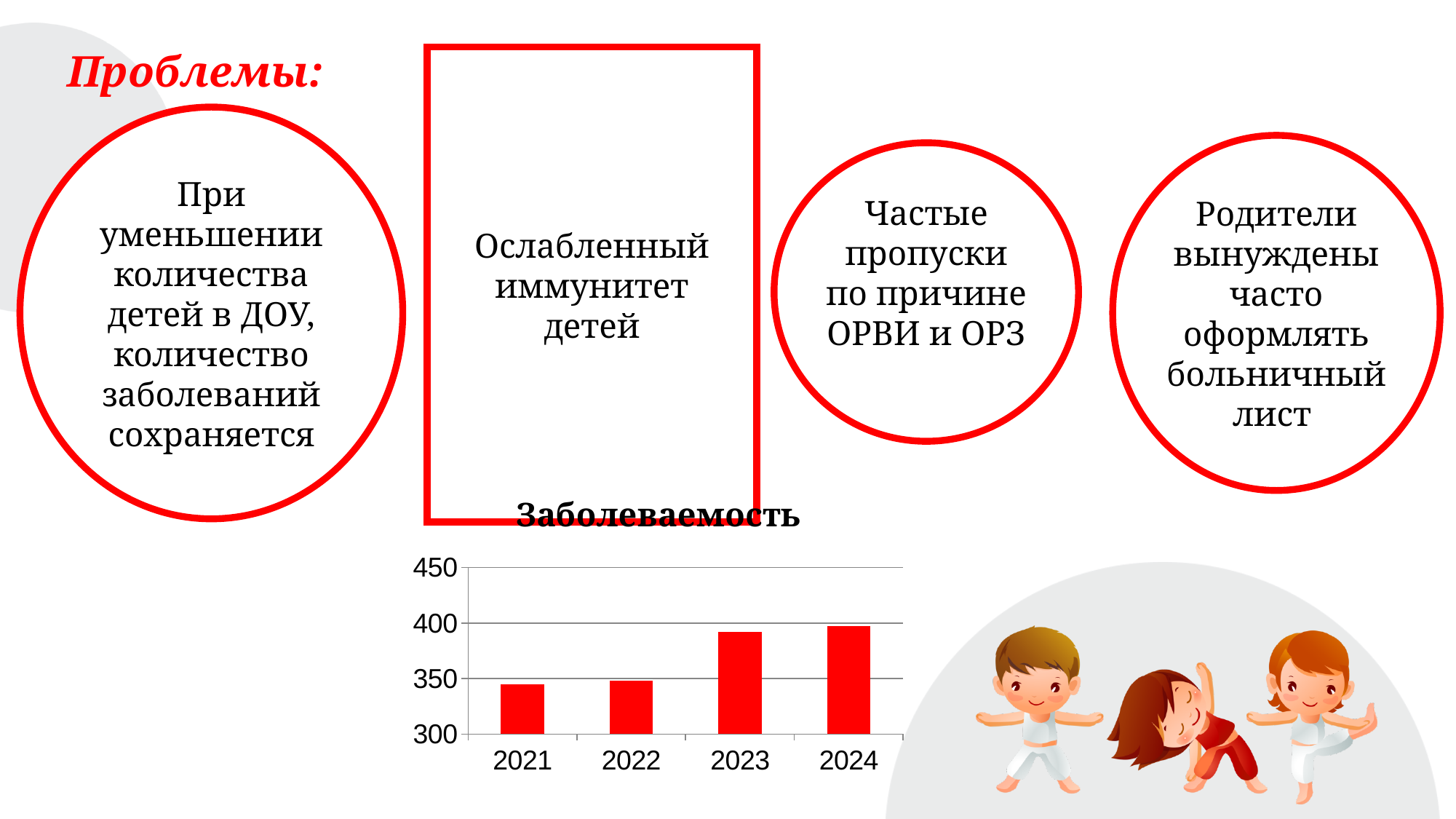
Do the values in the chart rise or fall from 2021 to 2024? rise What is the title of the chart? Заболеваемость How many years are shown on the x axis of the chart? 4 What colour are the bars in the chart? red What kind of chart is shown on the slide? bar chart Is the value for 2023 greater or less than 400? less Which year has the larger value, 2021 or 2023? 2023 Is the value for 2021 greater or less than 350? less Is the value for 2023 greater or less than 350? greater Which year has the larger value, 2022 or 2024? 2024